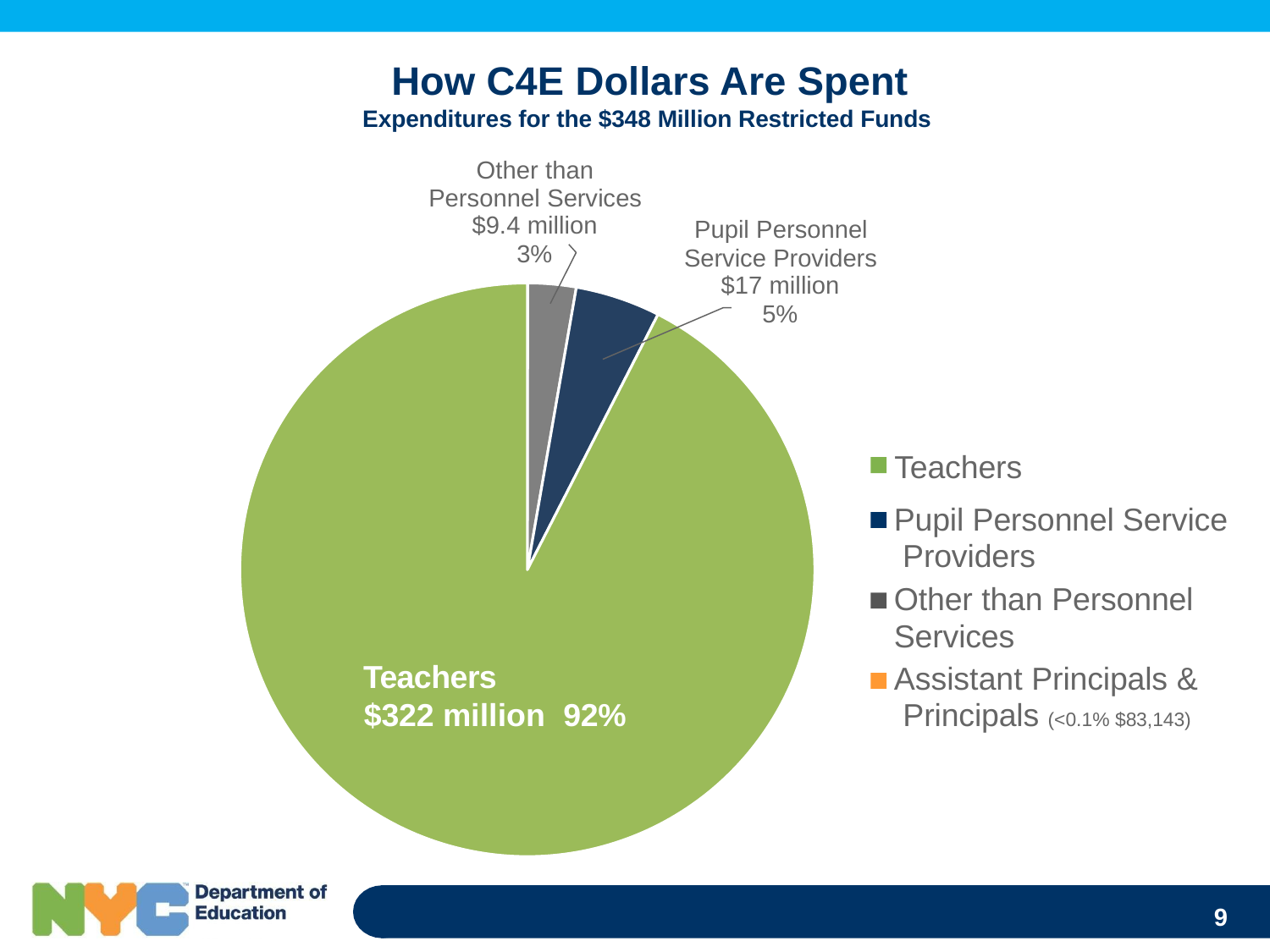
How much is spent on Teachers? $322 million Which category has the largest share of the pie? Teachers What share of the pie do Teachers account for? 92% What share of the pie does Other than Personnel Services account for? 3% How much is spent on Pupil Personnel Service Providers? $17 million What is the difference in percentage points between the Pupil Personnel Service Providers share and the Other than Personnel Services share? 2 percentage points How much is spent on Other than Personnel Services? $9.4 million Which is larger, the amount for Pupil Personnel Service Providers or for Other than Personnel Services? Pupil Personnel Service Providers What share of the pie do Pupil Personnel Service Providers account for? 5% What is the title of the chart? How C4E Dollars Are Spent How many categories does the legend list? 4 What kind of chart is shown on the slide? Pie chart